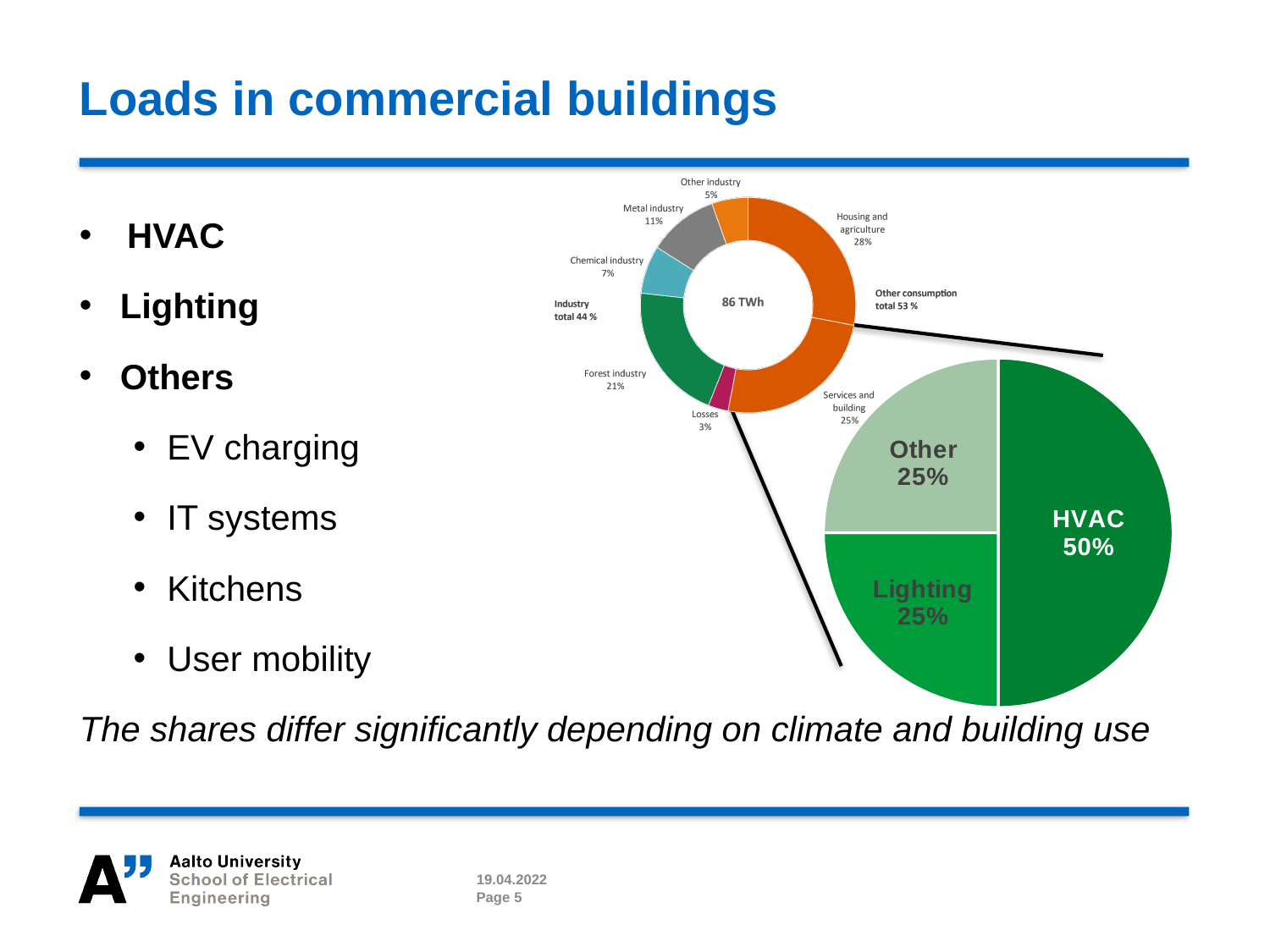
In the green pie chart at the bottom right, what share does HVAC have? 50% In the green pie chart at the bottom right, what share does Lighting have? 25% In the donut chart at the top, which is larger: Metal industry or Chemical industry? Metal industry In the donut chart at the top, which category has the smallest share? Losses In the donut chart at the top, what is the difference between the Services and building share and the Other industry share? 20% What total value is printed in the centre of the donut chart at the top? 86 TWh In the donut chart at the top, which category has the largest share? Housing and agriculture In the donut chart at the top, what is the share for Housing and agriculture? 28% In the green pie chart at the bottom right, which category has the largest share? HVAC In the donut chart at the top, what is the share for Forest industry? 21% In the green pie chart at the bottom right, what is the difference between the HVAC share and the Lighting share? 25% How many slices does the green pie chart at the bottom right have? 3